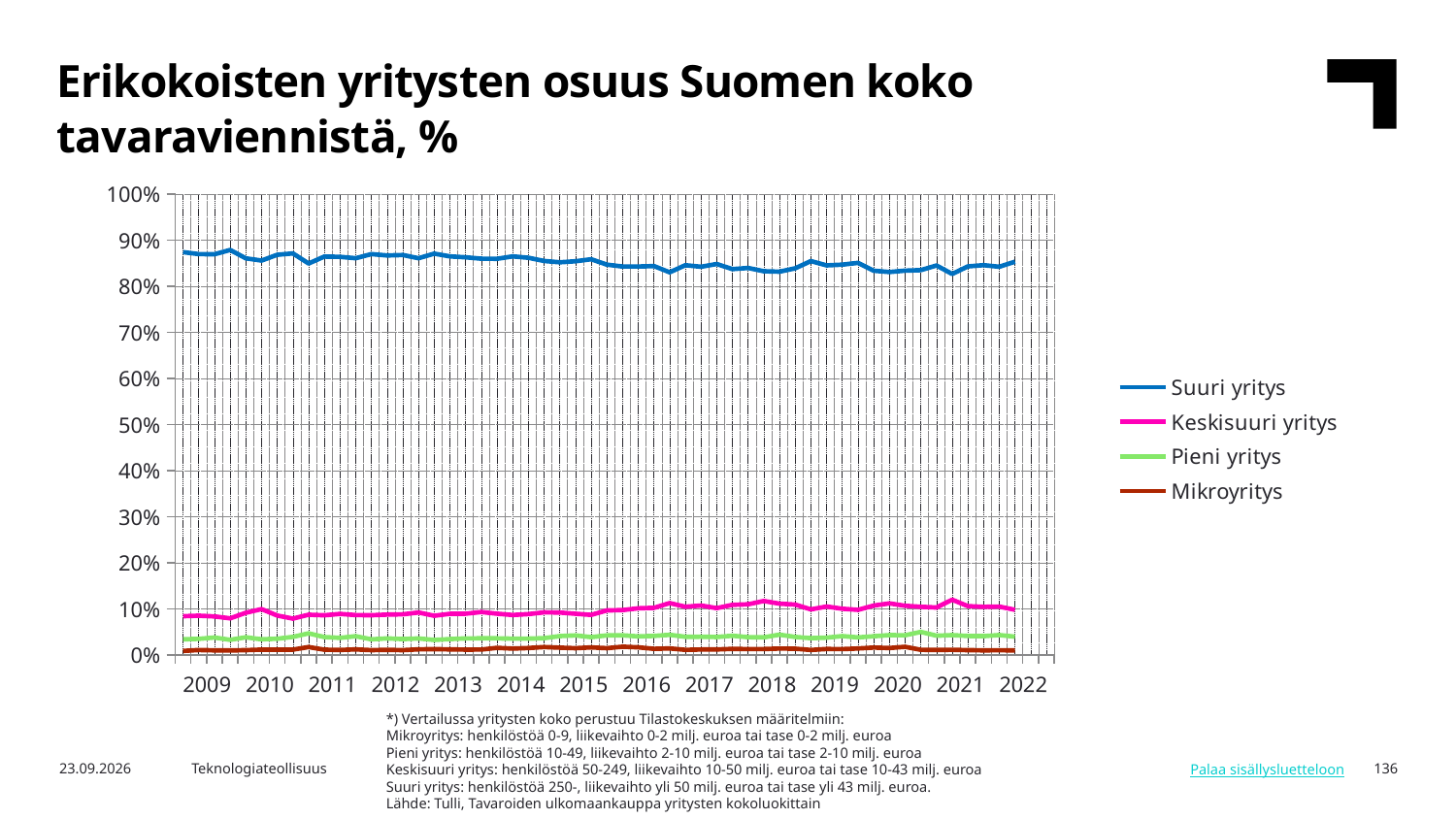
Which is larger in 2018: the share of Keskisuuri yritys or Pieni yritys? Keskisuuri yritys Which series is drawn with the blue line? Suuri yritys How many series does the legend list? 4 Which series has the highest share throughout the period? Suuri yritys Is the value for Pieni yritys in 2015 greater or less than 10%? less How many years are labelled on the x axis? 14 Which series has the lowest share throughout the period? Mikroyritys Is the value for Keskisuuri yritys in 2022 greater or less than 20%? less Is the value for Suuri yritys in 2022 greater or less than 90%? less What is the title of the chart? Erikokoisten yritysten osuus Suomen koko tavaraviennistä, % What kind of chart is shown on the slide? Line chart